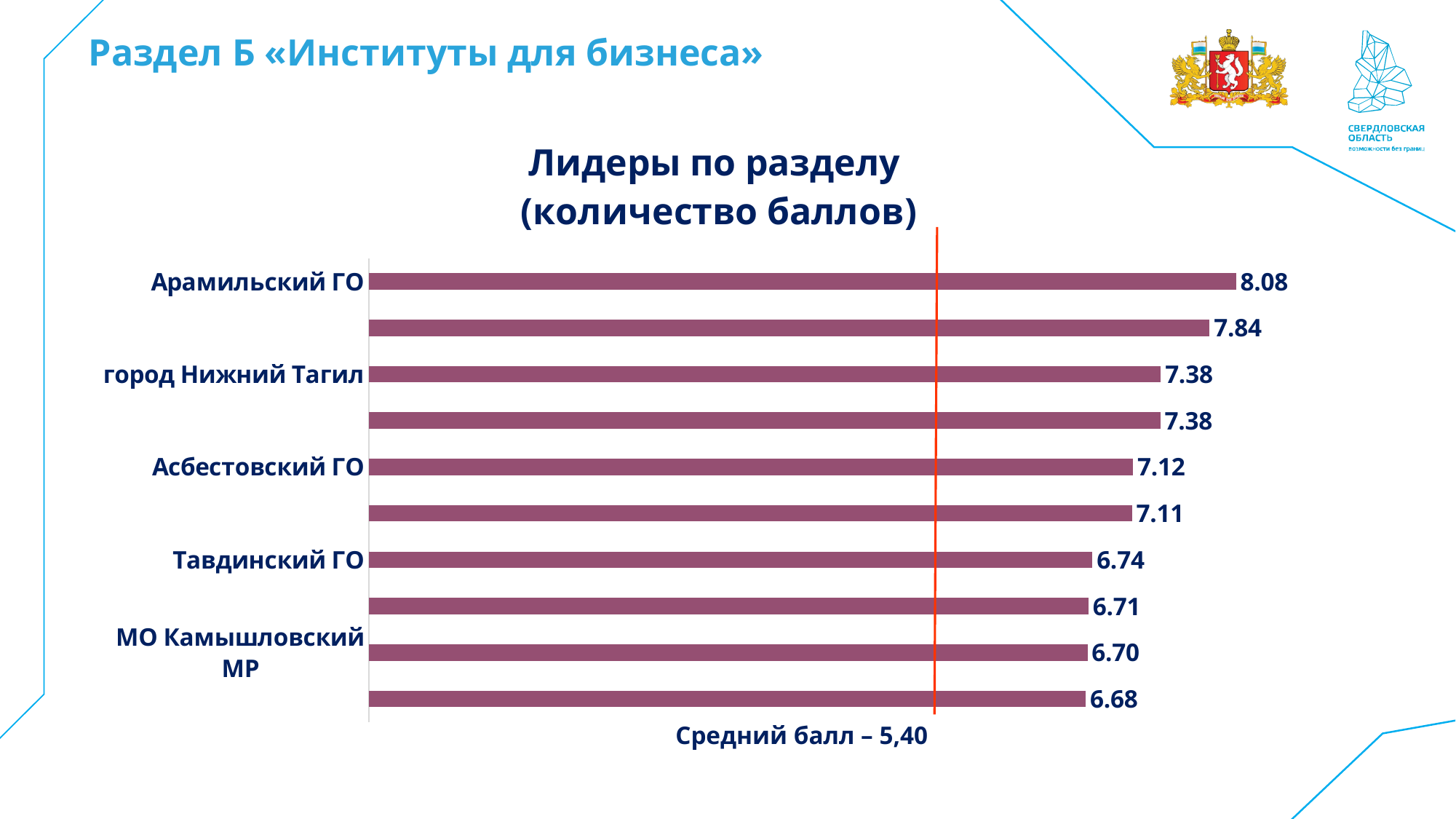
What kind of chart is shown? Bar chart What is the value for город Нижний Тагил? 7.38 Which is larger, the value for Тавдинский ГО or the value for МО Камышловский МР? Тавдинский ГО What average score (Средний балл) is marked by the red line on the chart? 5,40 Which category has the highest value? Арамильский ГО What is the value for Арамильский ГО? 8.08 What is the value for Тавдинский ГО? 6.74 What is the difference between the values for Арамильский ГО and Асбестовский ГО? 0.96 What is the value for Асбестовский ГО? 7.12 What is the value for МО Камышловский МР? 6.70 How many bars are plotted on the chart? 10 What is the lowest value shown on the chart? 6.68